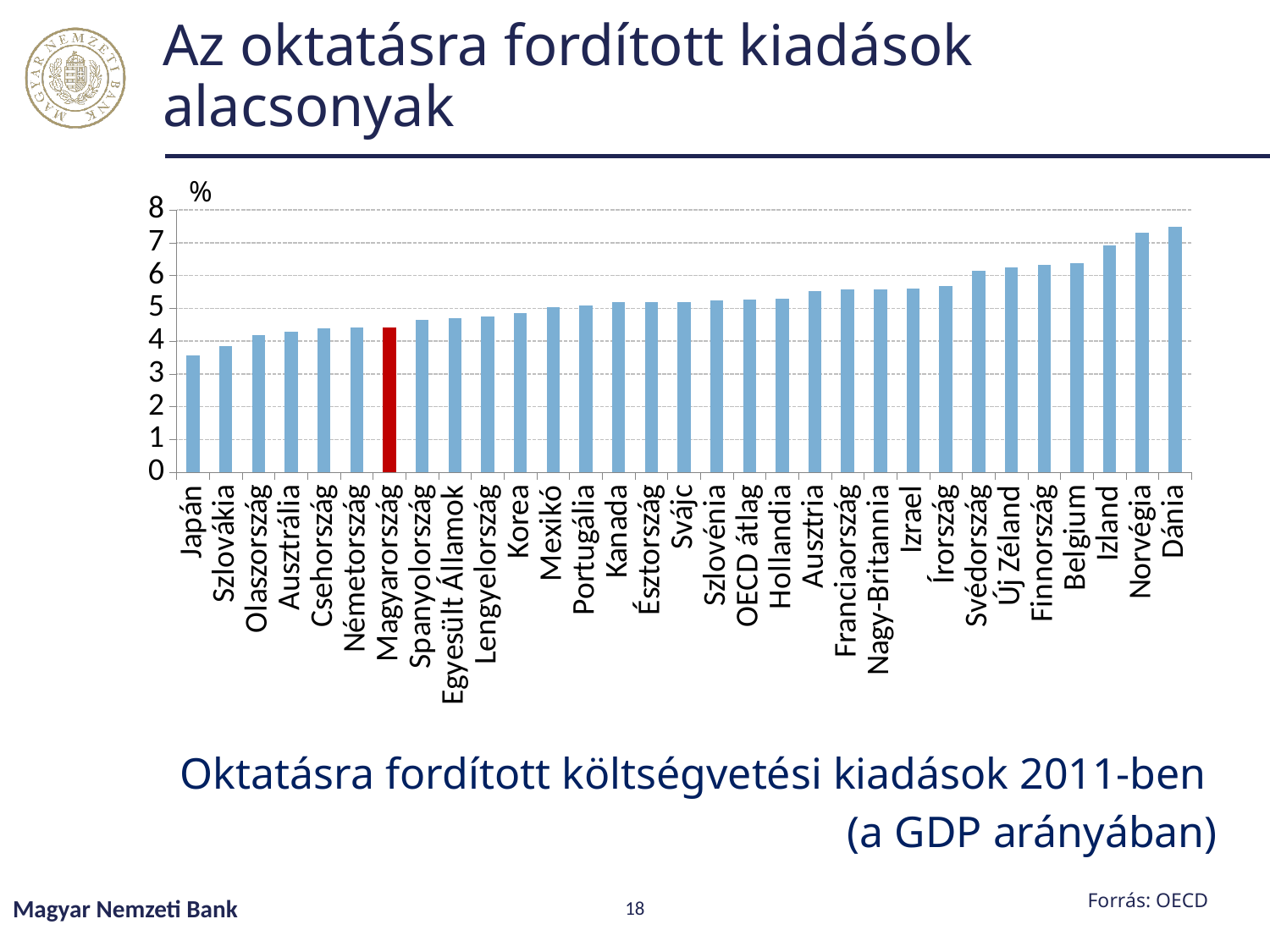
Do the values rise or fall from left to right along the x axis? rise Is the value for Svédország greater or less than 6? greater How many bars are plotted in the chart? 31 Which is larger, the value for Magyarország or the value for OECD átlag? OECD átlag Which country has the highest value in the chart? Dánia Is the value for Magyarország greater or less than 5? less Is the value for Dánia greater or less than 7? greater What kind of chart is shown on the slide? bar chart Which is larger, the value for Norvégia or the value for Szlovákia? Norvégia Which country has the lowest value in the chart? Japán Which country's bar is highlighted in red? Magyarország